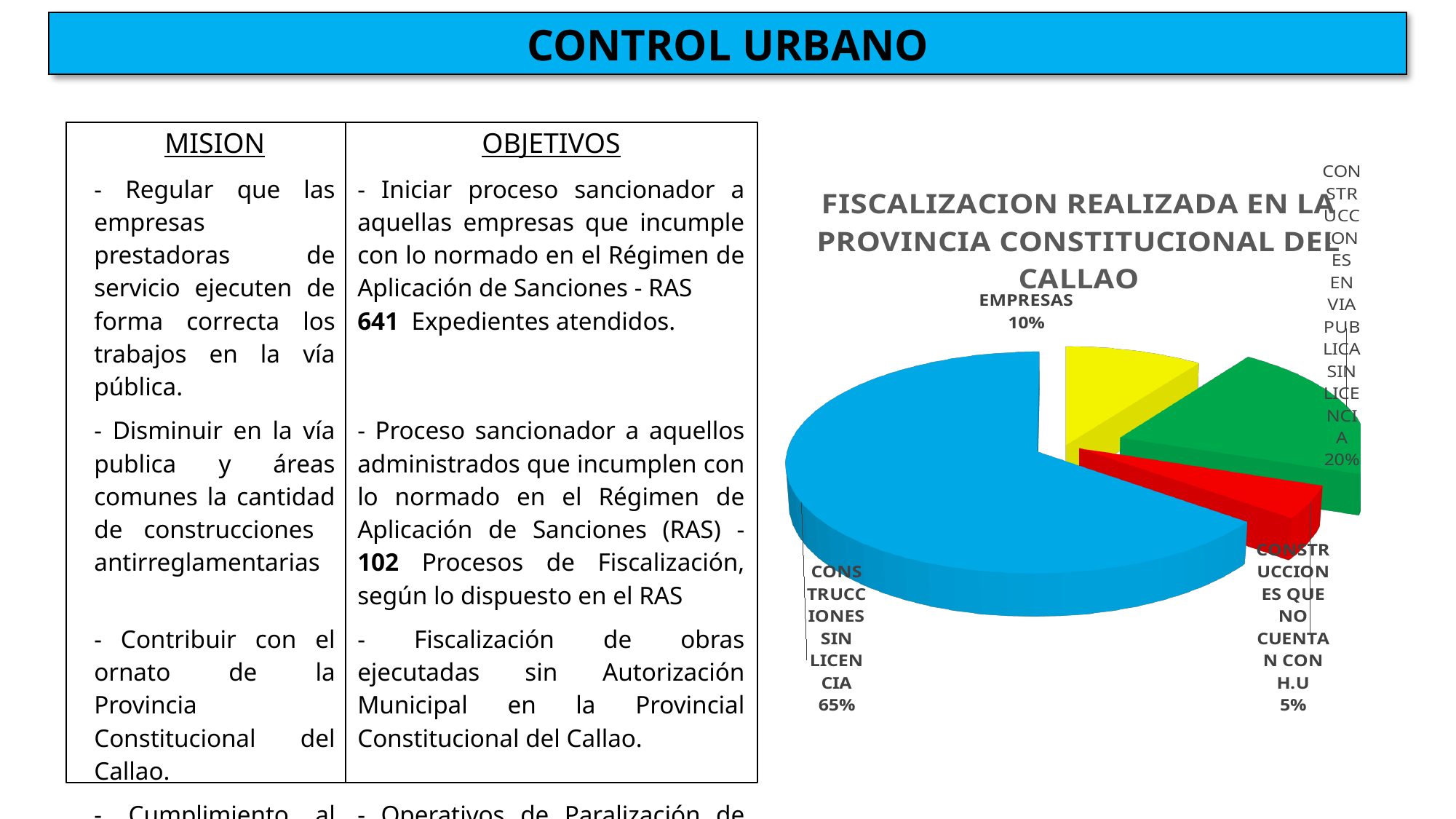
What is the title of the chart? FISCALIZACION REALIZADA EN LA PROVINCIA CONSTITUCIONAL DEL CALLAO Which is larger, the share for EMPRESAS or the share for CONSTRUCCIONES EN VIA PUBLICA SIN LICENCIA? CONSTRUCCIONES EN VIA PUBLICA SIN LICENCIA What colour is the slice for CONSTRUCCIONES SIN LICENCIA? Blue What share of the pie does CONSTRUCCIONES SIN LICENCIA represent? 65% What share of the pie does EMPRESAS represent? 10% What share of the pie does CONSTRUCCIONES EN VIA PUBLICA SIN LICENCIA represent? 20% Which category has the smallest slice of the pie? CONSTRUCCIONES QUE NO CUENTAN CON H.U What kind of chart is shown on the slide? Pie chart What is the difference in percentage points between CONSTRUCCIONES SIN LICENCIA and CONSTRUCCIONES EN VIA PUBLICA SIN LICENCIA? 45% Which category has the largest slice of the pie? CONSTRUCCIONES SIN LICENCIA How many slices does the pie chart have? 4